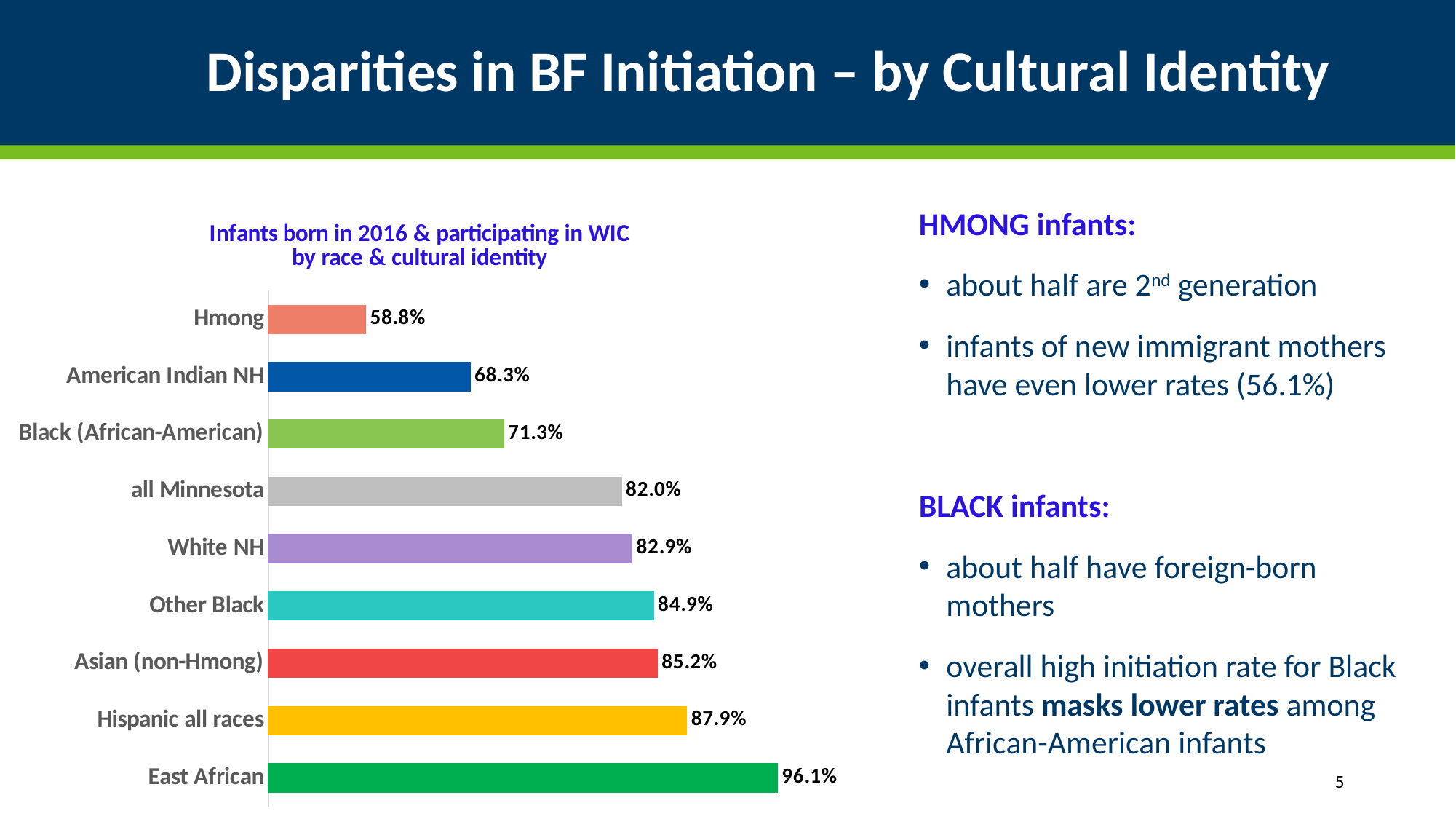
What is the title of the chart? Infants born in 2016 & participating in WIC by race & cultural identity What is the difference between the values for East African and Hmong? 37.3% What is the difference between the values for White NH and Black (African-American)? 11.6% Which is larger, the value for American Indian NH or the value for Black (African-American)? Black (African-American) What is the value for East African? 96.1% What is the value for Hmong? 58.8% Which category has the highest value? East African What is the value for all Minnesota? 82.0% What is the value for Hispanic all races? 87.9% How many categories are shown in the chart? 9 What kind of chart is shown on the slide? Bar chart Which category has the lowest value? Hmong